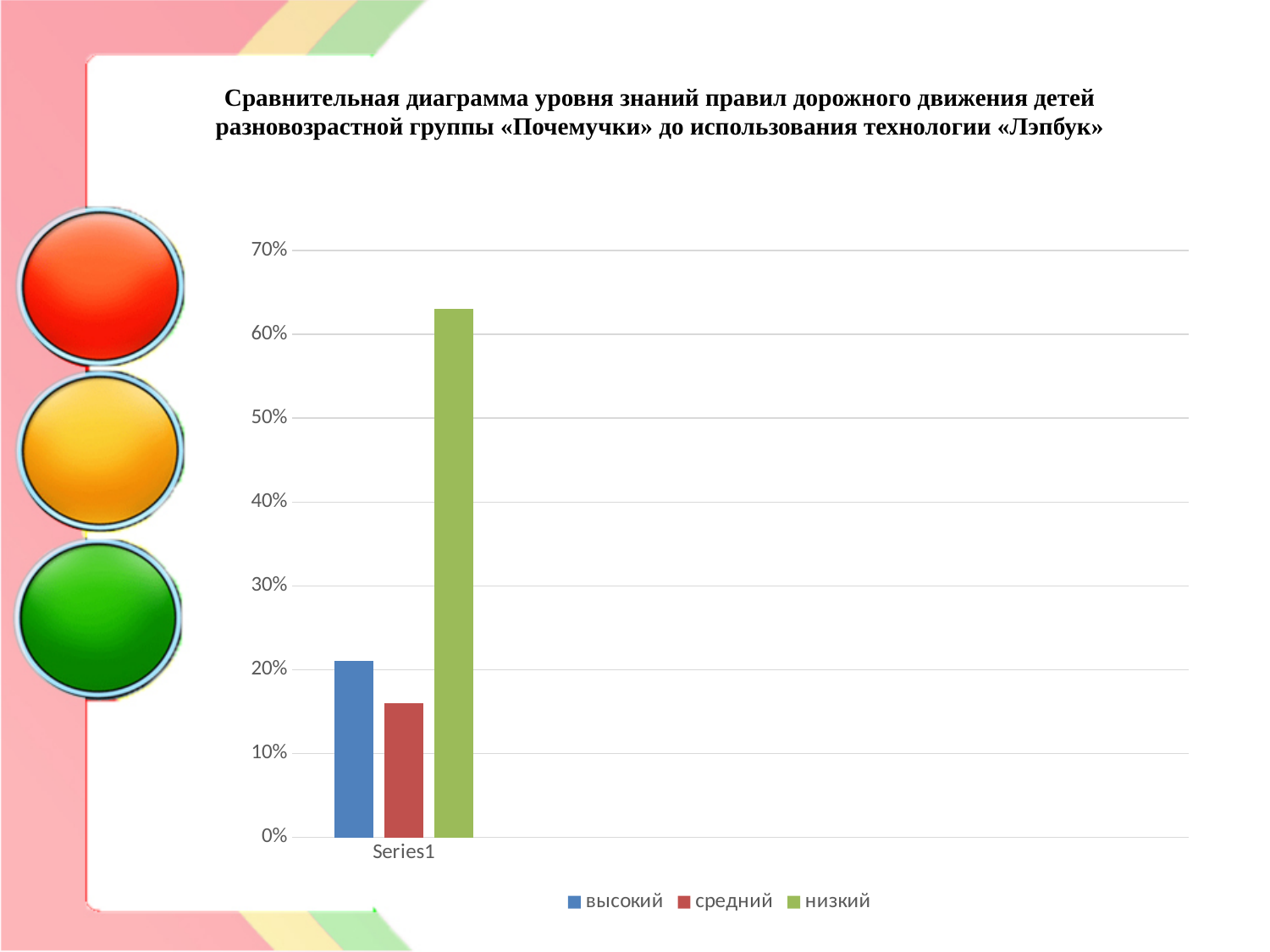
Which series has the highest bar? низкий How many categories are shown on the x axis? 1 Which is larger, the value for низкий or the value for высокий? низкий Is the value for высокий greater or less than 30%? less Which is larger, the value for высокий or the value for средний? высокий What colour is the bar for низкий? green Is the value for средний greater or less than 20%? less Is the value for низкий greater or less than 50%? greater What is the label of the category on the x axis? Series1 How many series does the legend list? 3 Which series has the lowest bar? средний What kind of chart is shown on the slide? bar chart